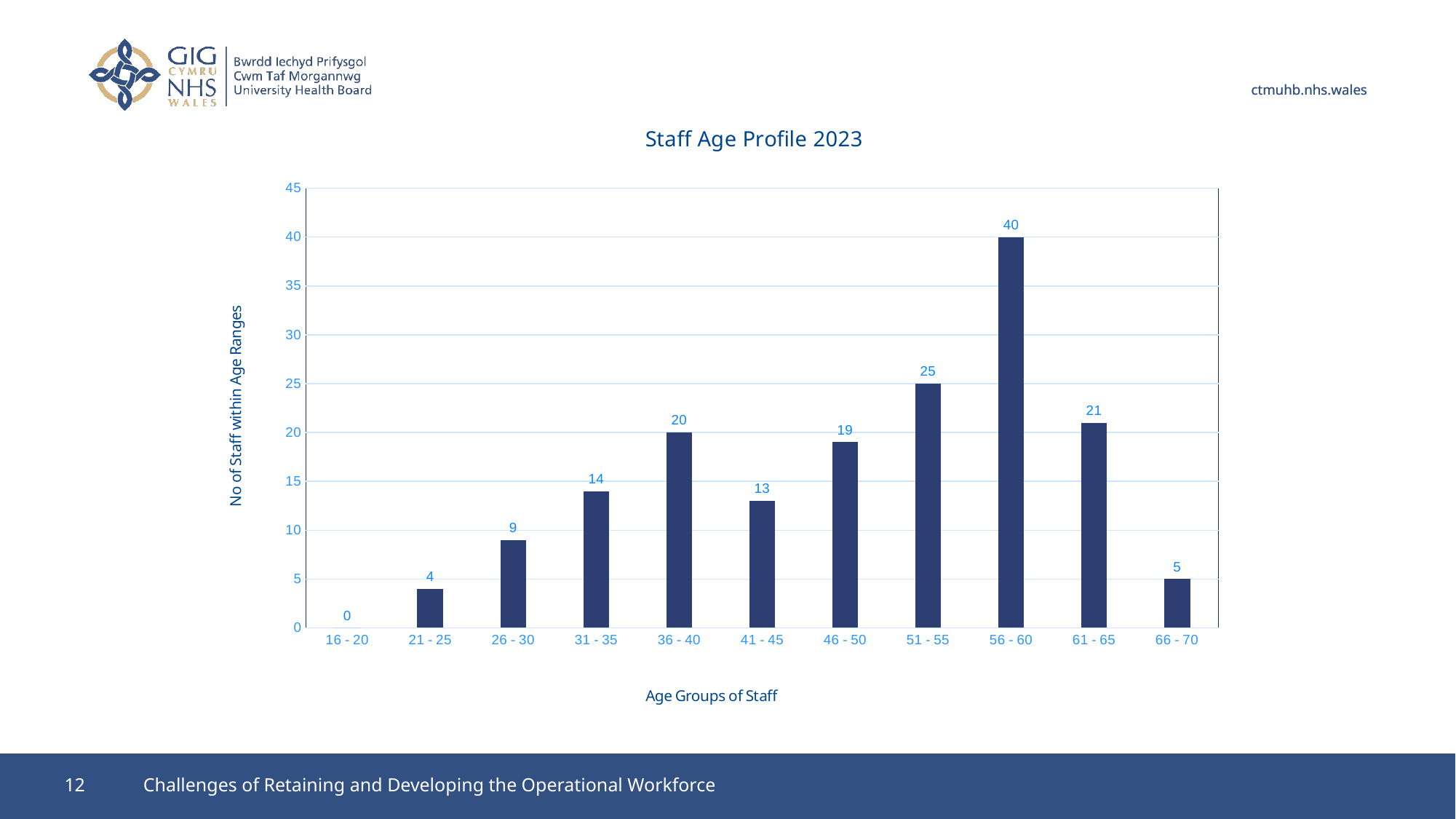
What is the difference in staff numbers between the 56 - 60 and 51 - 55 age groups? 15 What is the label of the y axis? No of Staff within Age Ranges Which age group has more staff, 46 - 50 or 61 - 65? 61 - 65 What is the number of staff in the 36 - 40 age group? 20 Which age group has the highest number of staff? 56 - 60 What is the number of staff in the 16 - 20 age group? 0 Which age group has the lowest number of staff? 16 - 20 What kind of chart is shown on the slide? Bar chart How many age groups are shown on the x axis? 11 Is the value for the 31 - 35 age group greater or less than 10? greater What is the number of staff in the 56 - 60 age group? 40 What is the title of the chart? Staff Age Profile 2023